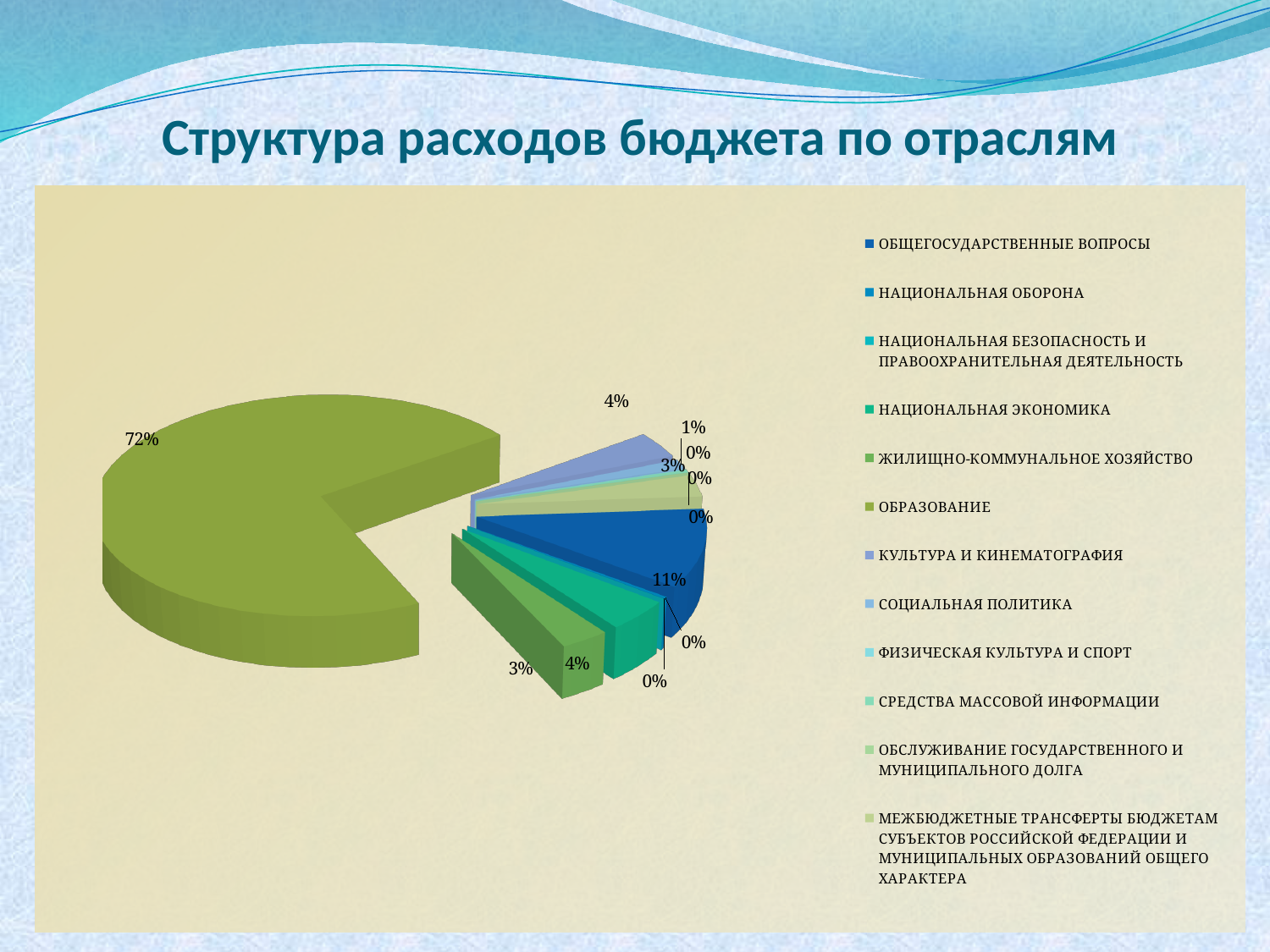
What is the value shown for ОБЩЕГОСУДАРСТВЕННЫЕ ВОПРОСЫ? 11% Which category has the largest share of the pie? ОБРАЗОВАНИЕ What is the second-largest percentage label shown on the pie chart? 11% Which is larger, the share of ОБРАЗОВАНИЕ or the share of ОБЩЕГОСУДАРСТВЕННЫЕ ВОПРОСЫ? ОБРАЗОВАНИЕ What is the difference between the shares of ОБРАЗОВАНИЕ and ОБЩЕГОСУДАРСТВЕННЫЕ ВОПРОСЫ? 61% What colour is the largest slice of the pie chart? green What is the title of the chart on the slide? Структура расходов бюджета по отраслям What share of the pie does ОБРАЗОВАНИЕ take? 72% What kind of chart is shown on the slide? pie chart How many categories does the legend of the pie chart list? 12